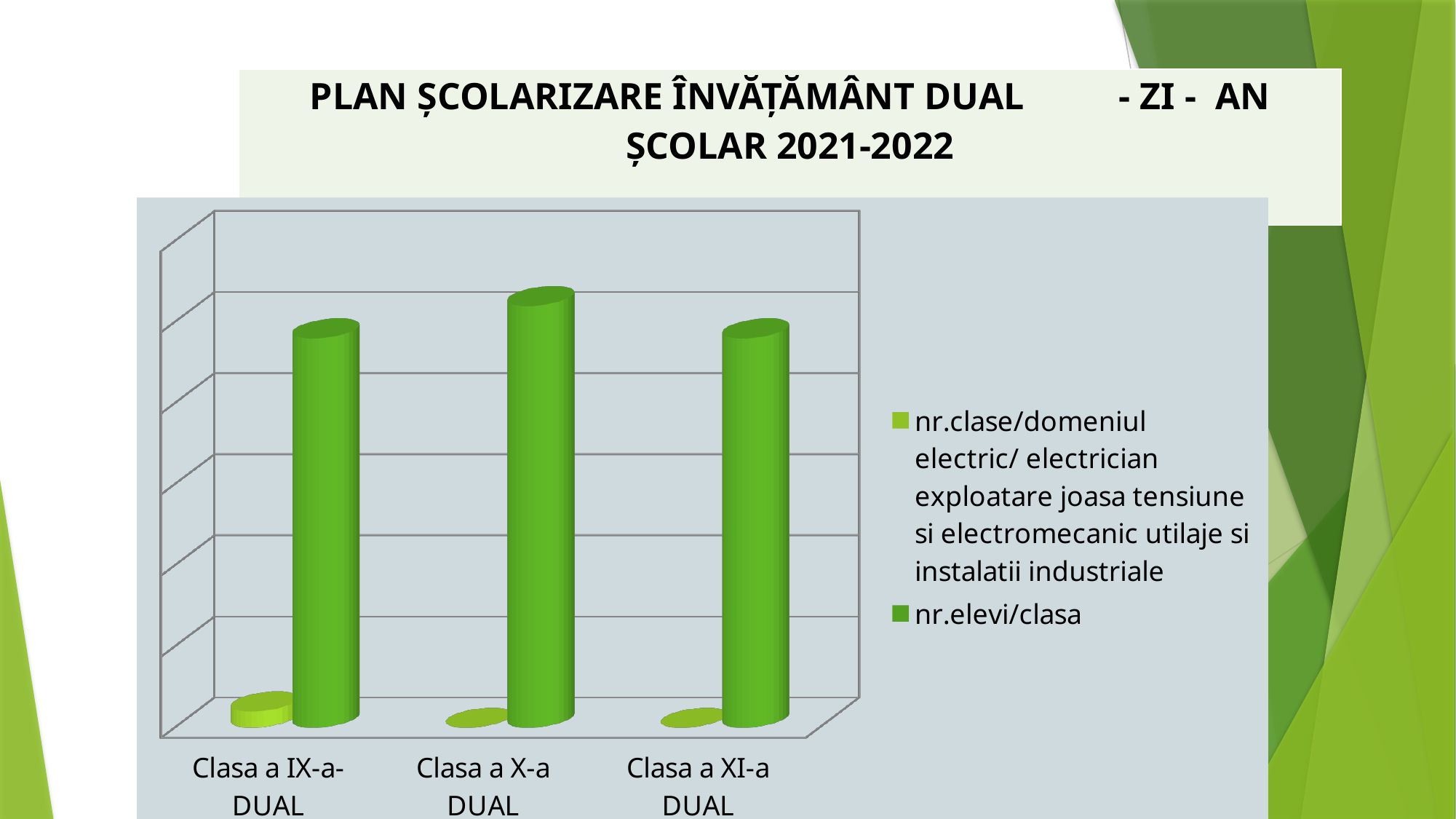
What is the title shown above the chart on the slide? PLAN ȘCOLARIZARE ÎNVĂȚĂMÂNT DUAL - ZI - AN ȘCOLAR 2021-2022 What kind of chart is shown on the slide? bar chart For the nr.elevi/clasa series, which is larger: Clasa a IX-a-DUAL or Clasa a X-a DUAL? Clasa a X-a DUAL Which category has the highest value for the nr.elevi/clasa series? Clasa a X-a DUAL What is the second entry listed in the chart's legend? nr.elevi/clasa Which series has the smaller values across all categories in the chart? nr.clase/domeniul electric/ electrician exploatare joasa tensiune si electromecanic utilaje si instalatii industriale How many categories are shown on the x axis of the chart? 3 How many series does the chart's legend list? 2 For the nr.elevi/clasa series, which is larger: Clasa a X-a DUAL or Clasa a XI-a DUAL? Clasa a X-a DUAL For Clasa a IX-a-DUAL, which series has the larger value: nr.elevi/clasa or nr.clase/domeniul electric? nr.elevi/clasa